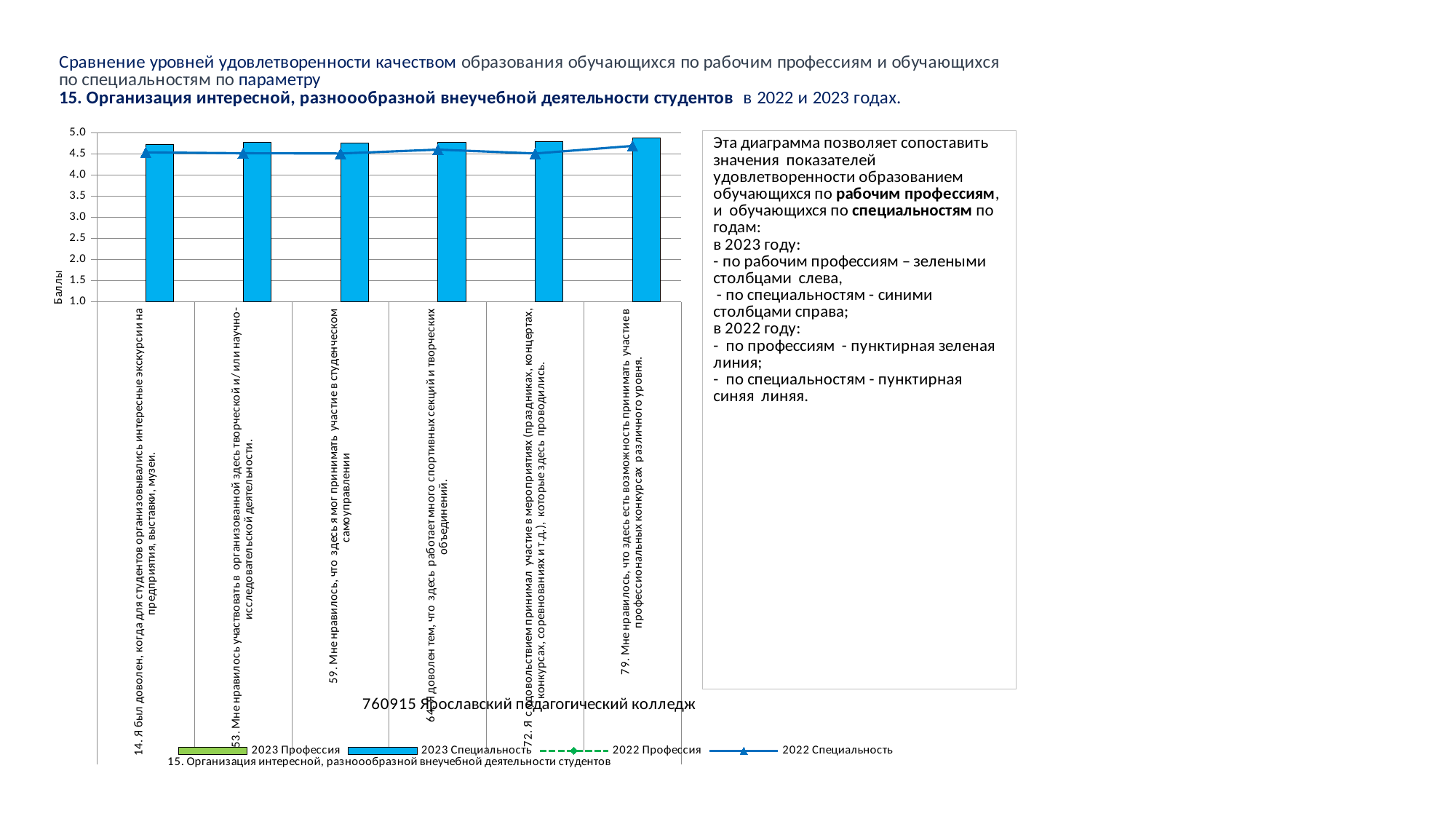
Is the 2022 Специальность line value for category 72 greater or less than 5.0? less Does the 2022 Специальность line rise or fall from category 72 to category 79? rises How many series does the chart legend list? 4 How many categories (questions) are shown along the x axis of the chart? 6 Which category has the highest 2023 Специальность bar? 79. Мне нравилось, что здесь есть возможность принимать участие в профессиональных конкурсах различного уровня. Which is larger: the 2023 Специальность bar for category 79 or for category 14? Category 79 What kind of chart is shown on the slide? Bar chart combined with a line Which legend entry is represented by the solid blue bars? 2023 Специальность Is the 2022 Специальность line value for category 53 greater or less than 4.0? greater Is the 2023 Специальность bar for category 79 greater or less than 4.5? greater What is the label of the vertical axis of the chart? Баллы